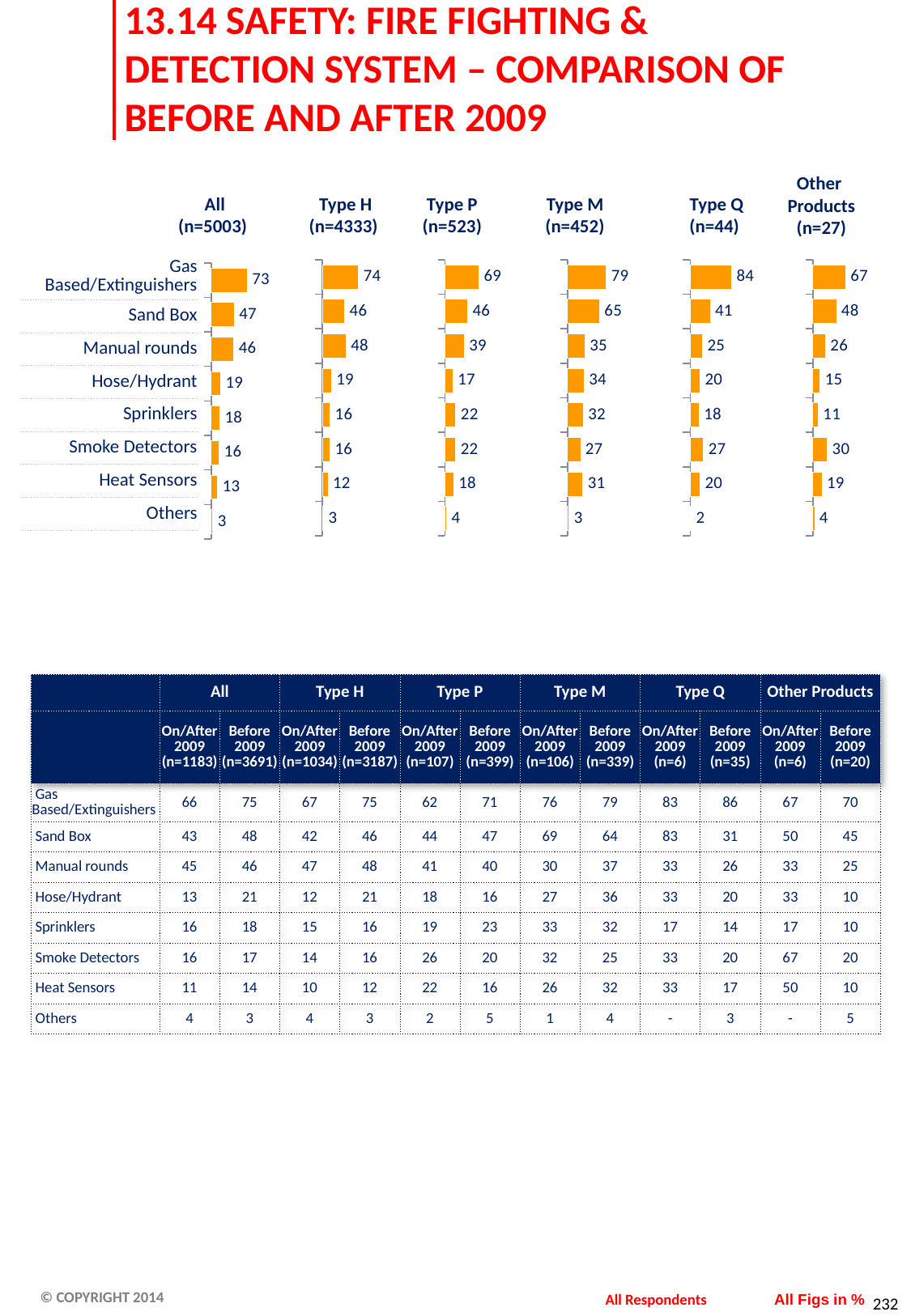
In the 'Type Q (n=44)' chart, which category has the highest value? Gas Based/Extinguishers In the 'Type Q (n=44)' chart, what is the value for Others? 2 In the 'Type P (n=523)' chart, which is larger: Sand Box or Manual rounds? Sand Box What colour are the bars in the charts on the slide? Orange What kind of chart is the 'Type M (n=452)' chart? Bar chart How many categories are shown in the 'All (n=5003)' chart? 8 In the 'Other Products (n=27)' chart, what is the value for Smoke Detectors? 30 In the 'Type H (n=4333)' chart, what is the difference between Gas Based/Extinguishers and Manual rounds? 26 In the 'Type M (n=452)' chart, what is the value for Sand Box? 65 In the 'All (n=5003)' chart, what is the value for Gas Based/Extinguishers? 73 In the 'Other Products (n=27)' chart, which category has the lowest value? Others How many separate bar charts are shown on the slide? 6